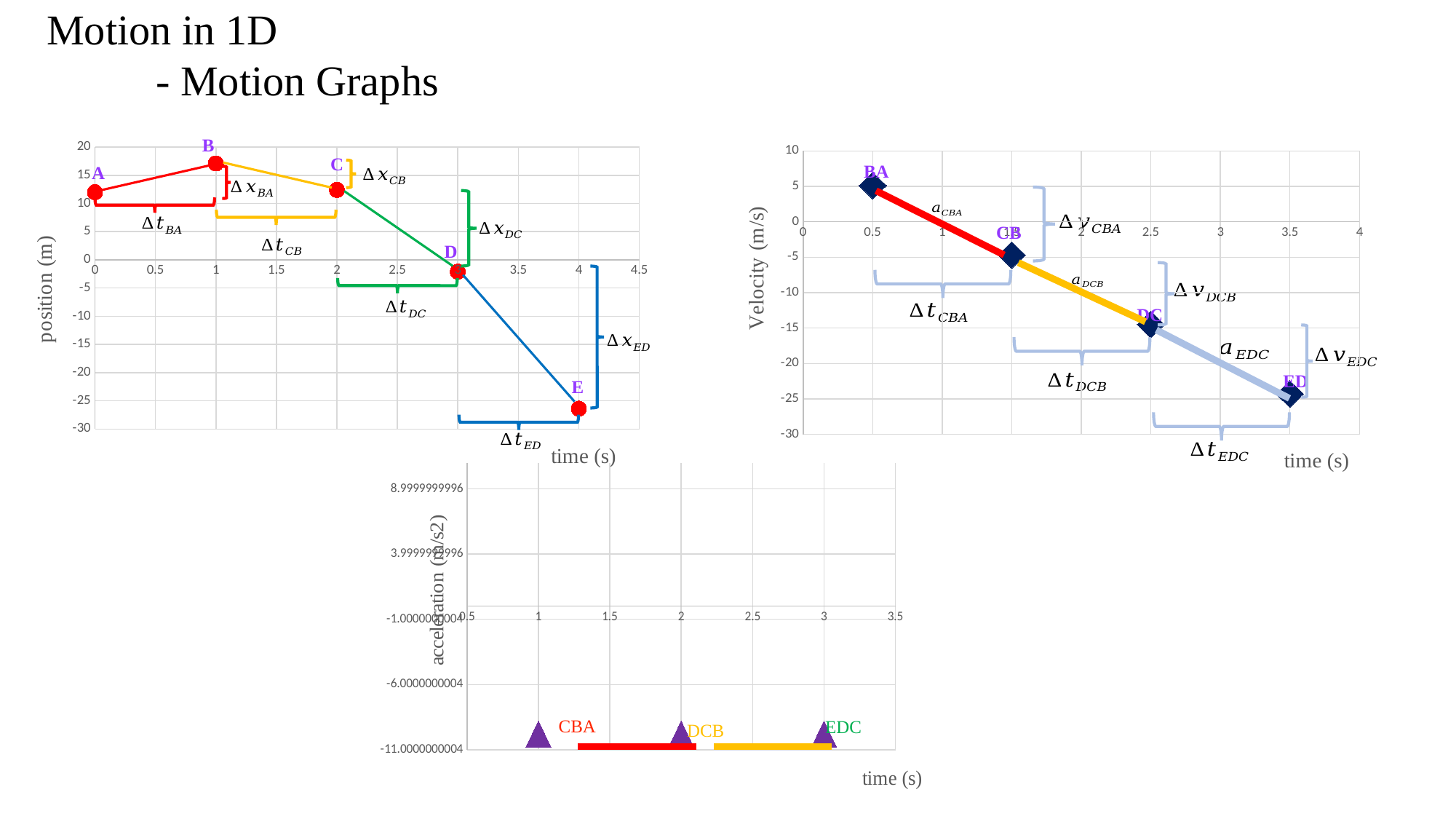
On the position (m) chart at the top left, how many labelled data points are plotted? 5 On the position (m) chart at the top left, is the position at point B greater or less than 15? greater What kind of chart is the position (m) versus time (s) chart at the top left? line chart On the Velocity (m/s) chart at the top right, do the velocity values rise or fall as time increases? fall On the acceleration (m/s2) chart at the bottom, how many triangle markers are plotted? 3 On the Velocity (m/s) chart at the top right, how many data points are plotted? 4 On the position (m) chart at the top left, is the position at point E greater or less than -20? less On the position (m) chart at the top left, which labelled point has the lowest position? E On the Velocity (m/s) chart at the top right, which point has the larger velocity, BA or DC? BA On the position (m) chart at the top left, which labelled point has the highest position? B